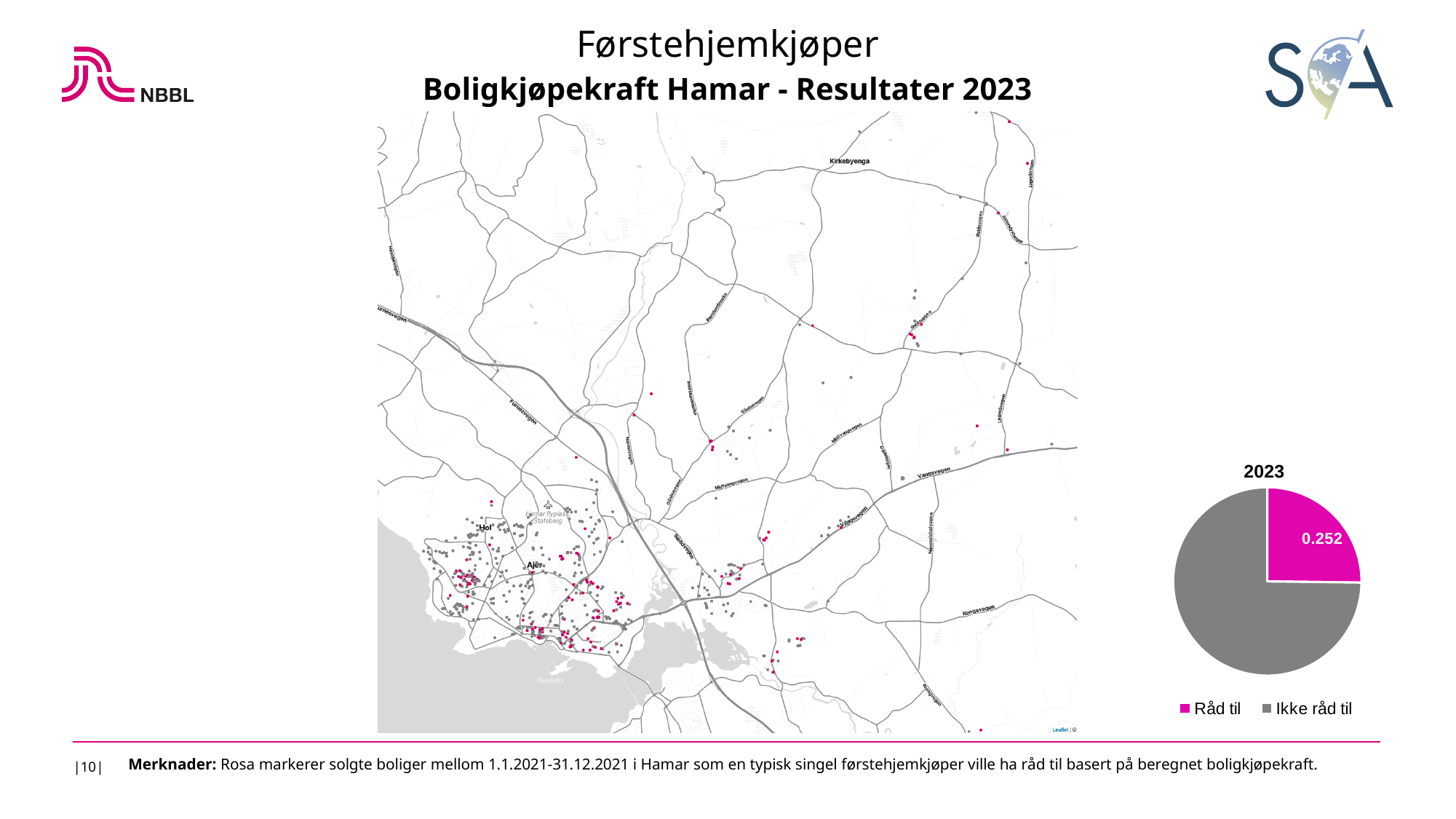
How many entries does the legend of the pie chart titled "2023" list? 2 In the pie chart titled "2023", what value is shown for "Råd til"? 0.252 In the pie chart titled "2023", is the "Råd til" slice greater or less than half of the pie? less In the pie chart titled "2023", which is larger: the "Råd til" slice or the "Ikke råd til" slice? Ikke råd til How many slices does the pie chart titled "2023" have? 2 In the pie chart titled "2023", which category has the smallest slice? Råd til What is the title of the pie chart on the right of the slide? 2023 In the pie chart titled "2023", what colour is the "Råd til" slice? pink In the pie chart titled "2023", what share of the pie does the "Råd til" slice represent? 0.252 What kind of chart is the chart titled "2023" on the right of the slide? pie chart In the pie chart titled "2023", which category has the largest slice? Ikke råd til